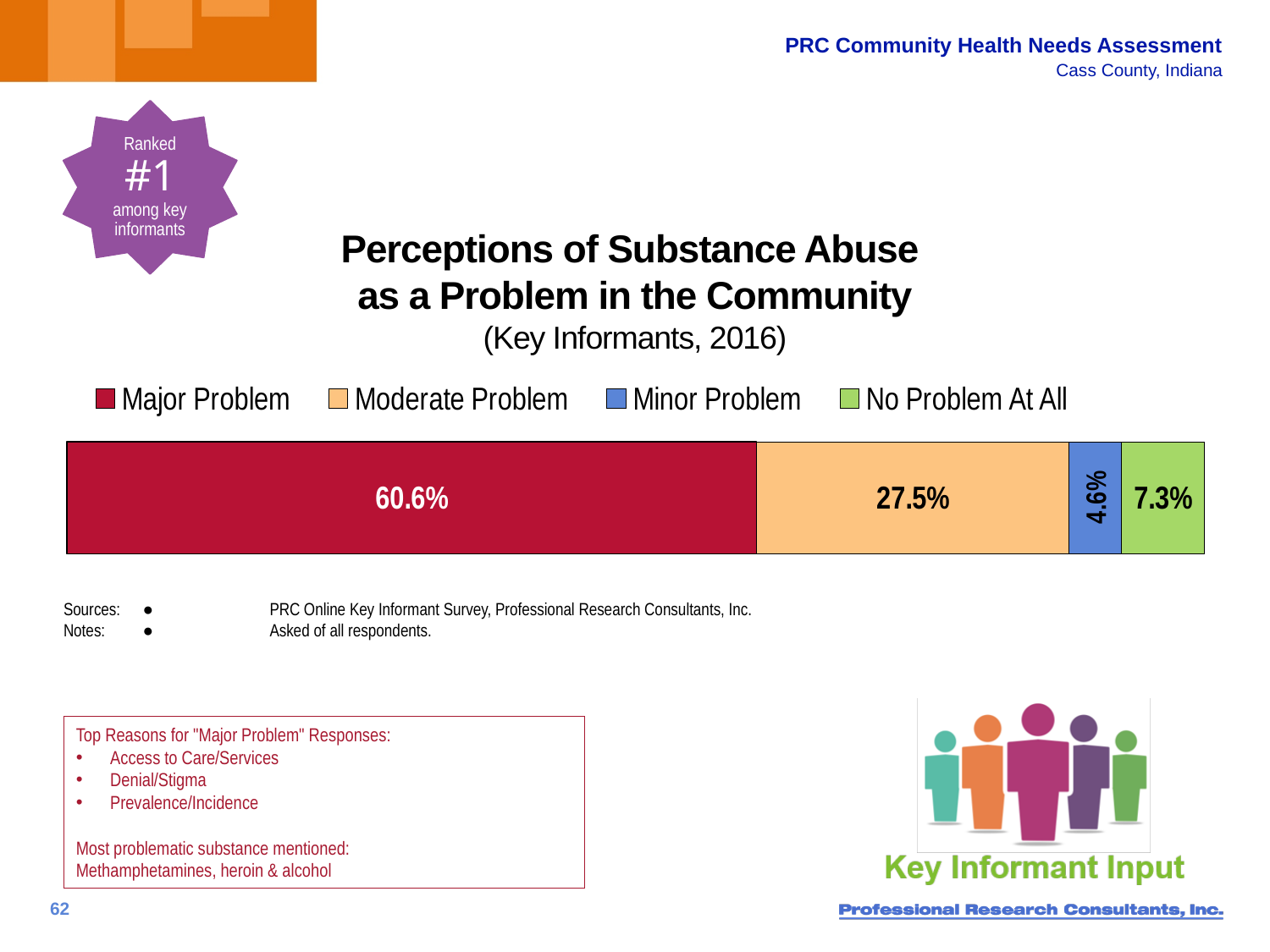
What is the combined percentage for Major Problem and Moderate Problem? 88.1% Which response category has the smallest share? Minor Problem What percentage of key informants rated substance abuse a Minor Problem? 4.6% What percentage of key informants rated substance abuse a Major Problem? 60.6% What percentage of key informants said substance abuse is No Problem At All? 7.3% Which response category has the largest share? Major Problem What percentage of key informants rated substance abuse a Moderate Problem? 27.5% What kind of chart is shown on the slide? Stacked bar chart Which is larger, the share for No Problem At All or the share for Minor Problem? No Problem At All What is the difference in percentage points between Major Problem and Moderate Problem? 33.1 What colour represents the Major Problem category in the chart? Red How many response categories does the legend list? 4